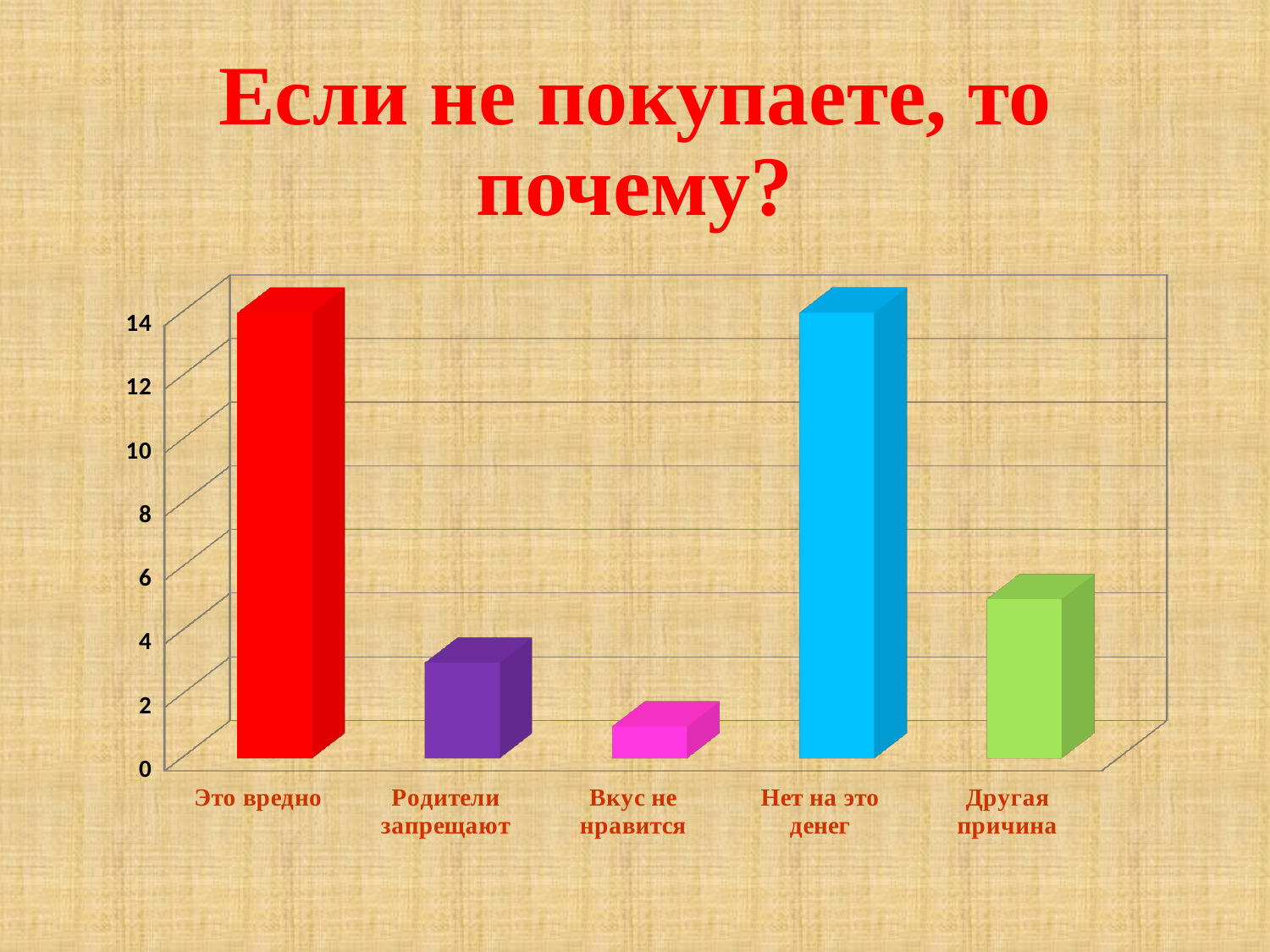
Which is larger: the value for "Это вредно" or for "Родители запрещают"? Это вредно Which is larger: the value for "Другая причина" or for "Вкус не нравится"? Другая причина Which category has the lowest value? Вкус не нравится Is the value for "Родители запрещают" greater or less than 6? less What is the title of the slide above the chart? Если не покупаете, то почему? Is the value for "Это вредно" greater or less than 10? greater Is the value for "Вкус не нравится" greater or less than 2? less What colour is the bar for "Нет на это денег"? blue How many categories are shown in the chart? 5 What kind of chart is shown on the slide? bar chart